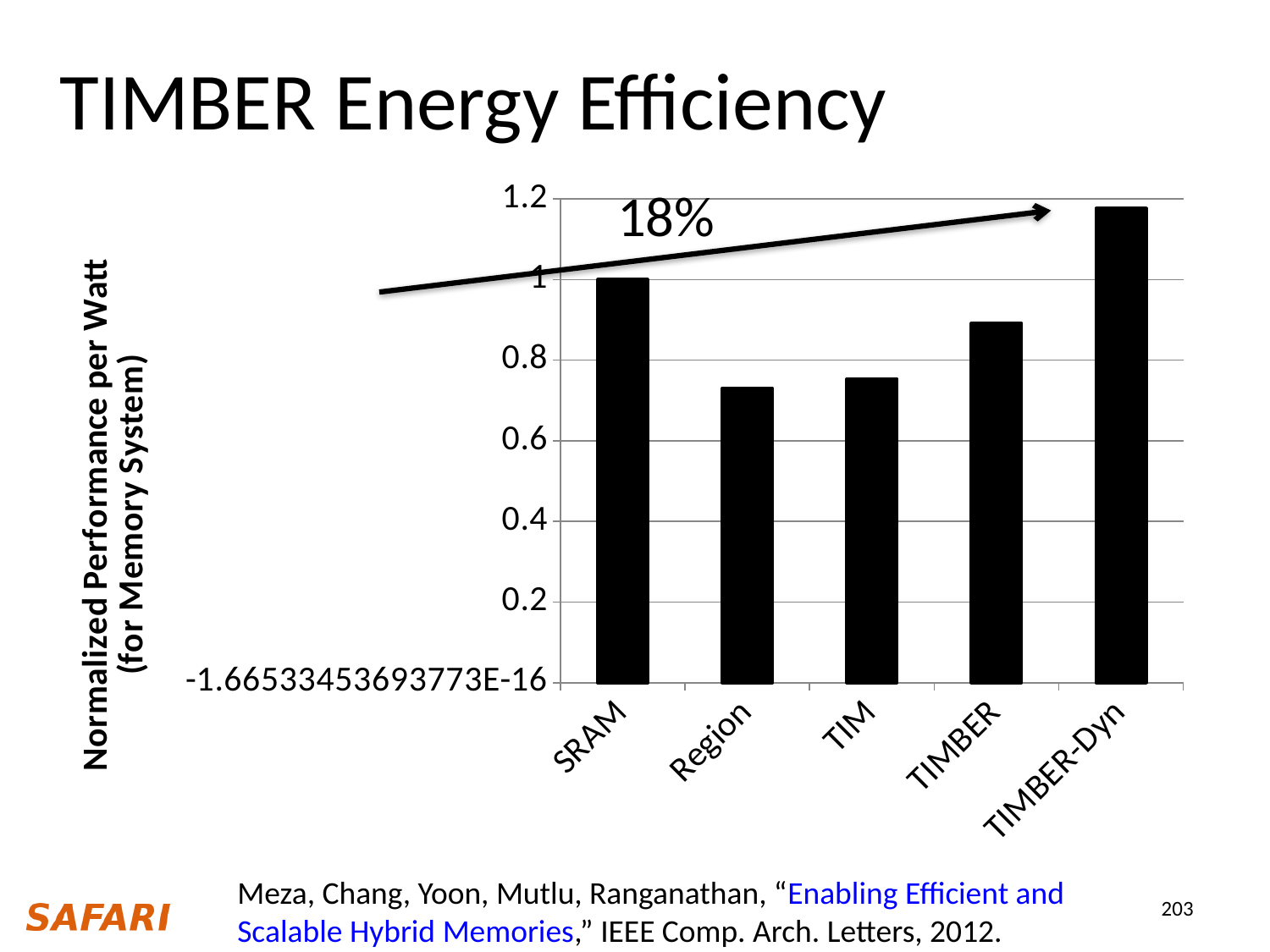
Is the value for TIMBER greater or less than 0.8? greater Is the value for TIMBER-Dyn greater or less than 1? greater What is the label of the y axis of the chart? Normalized Performance per Watt (for Memory System) Is the value for Region greater or less than 0.8? less Which has a larger normalized performance per watt, SRAM or Region? SRAM Which has a larger normalized performance per watt, TIMBER or TIM? TIMBER What is the normalized performance per watt for SRAM? 1 Which category has the highest normalized performance per watt? TIMBER-Dyn How many categories are plotted on the x axis of the chart? 5 What kind of chart is shown on the slide? bar chart What percentage is written next to the arrow annotation on the chart? 18%